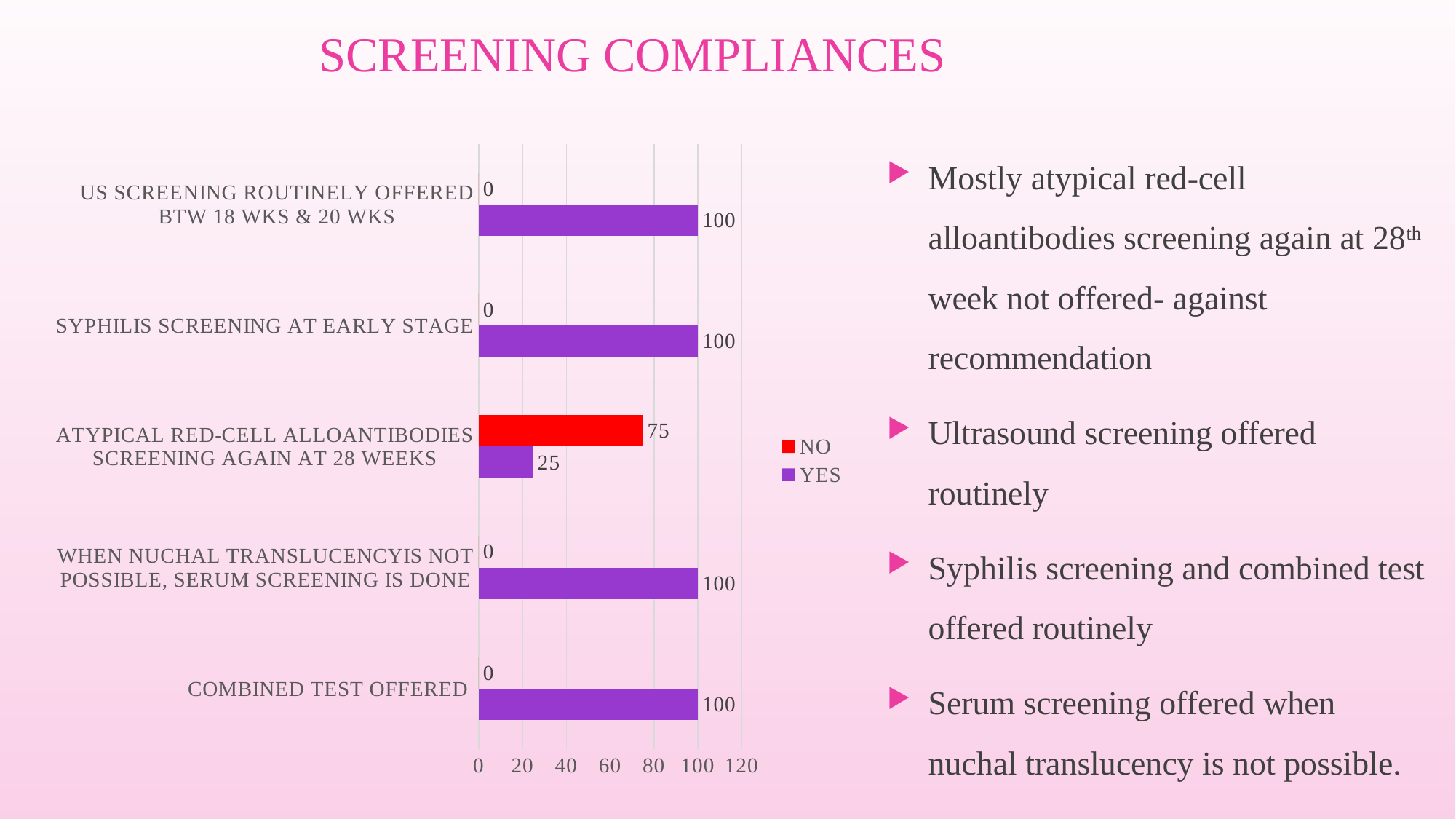
Which category has the lowest YES value? ATYPICAL RED-CELL ALLOANTIBODIES SCREENING AGAIN AT 28 WEEKS What kind of chart is shown on the slide? Bar chart What is the NO value for SYPHILIS SCREENING AT EARLY STAGE? 0 What is the YES value for ATYPICAL RED-CELL ALLOANTIBODIES SCREENING AGAIN AT 28 WEEKS? 25 How many series does the legend list? 2 For ATYPICAL RED-CELL ALLOANTIBODIES SCREENING AGAIN AT 28 WEEKS, which is larger, the NO value or the YES value? NO What is the difference between the NO and YES values for ATYPICAL RED-CELL ALLOANTIBODIES SCREENING AGAIN AT 28 WEEKS? 50 What is the NO value for ATYPICAL RED-CELL ALLOANTIBODIES SCREENING AGAIN AT 28 WEEKS? 75 Which colour represents the YES series in the chart? Purple Which category has the highest NO value? ATYPICAL RED-CELL ALLOANTIBODIES SCREENING AGAIN AT 28 WEEKS What is the YES value for COMBINED TEST OFFERED? 100 How many categories are shown on the chart? 5